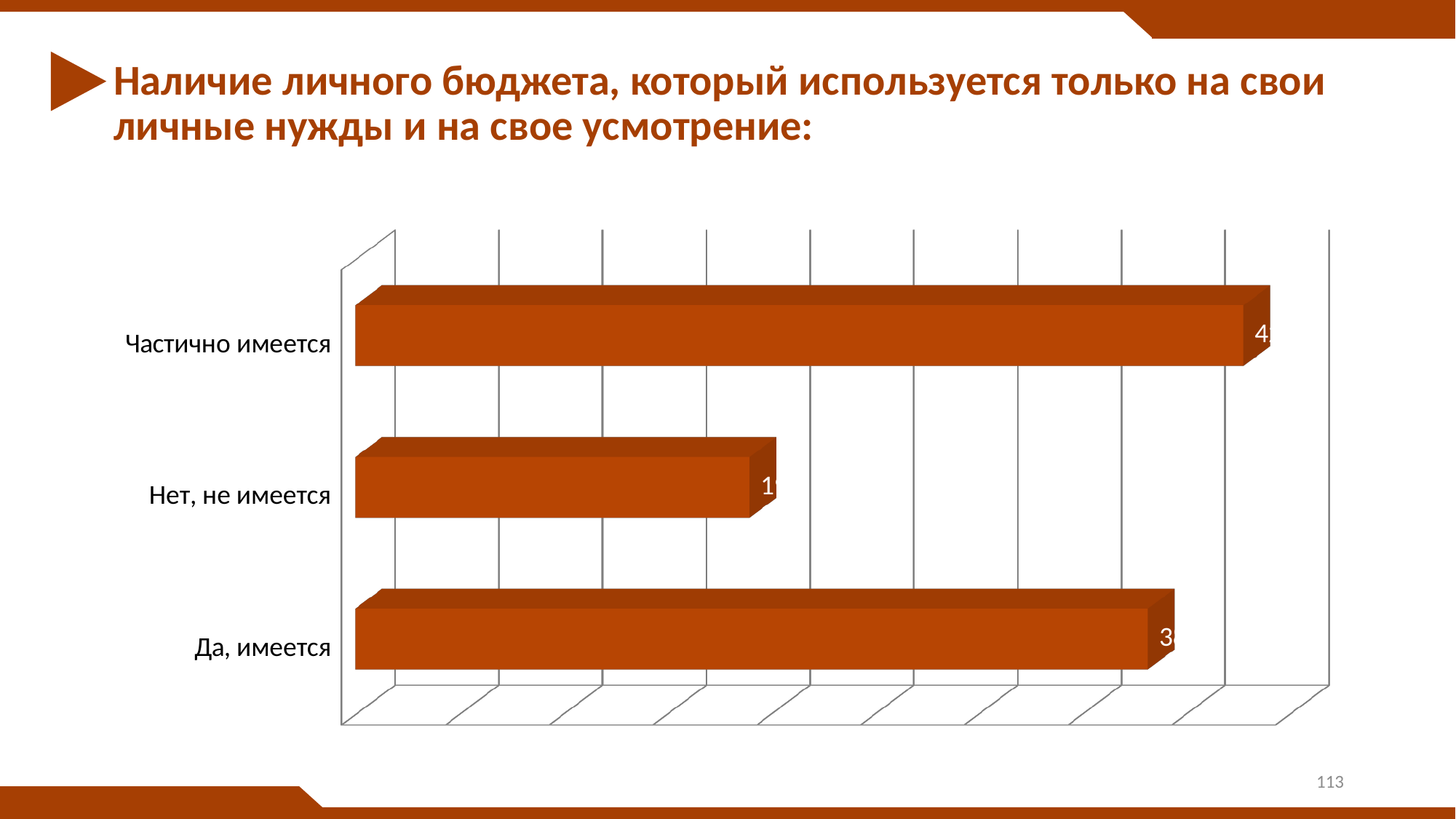
Which is larger: the value for "Да, имеется" or the value for "Нет, не имеется"? Да, имеется Which category has the longest bar in the chart? Частично имеется What is the title of the slide above the chart? Наличие личного бюджета, который используется только на свои личные нужды и на свое усмотрение: Which is larger: the value for "Частично имеется" or the value for "Да, имеется"? Частично имеется How many categories are shown in the chart? 3 Which is smaller: the value for "Нет, не имеется" or the value for "Частично имеется"? Нет, не имеется Which category has the shortest bar in the chart? Нет, не имеется Which category is listed at the bottom of the chart? Да, имеется What kind of chart is shown on the slide? Bar chart